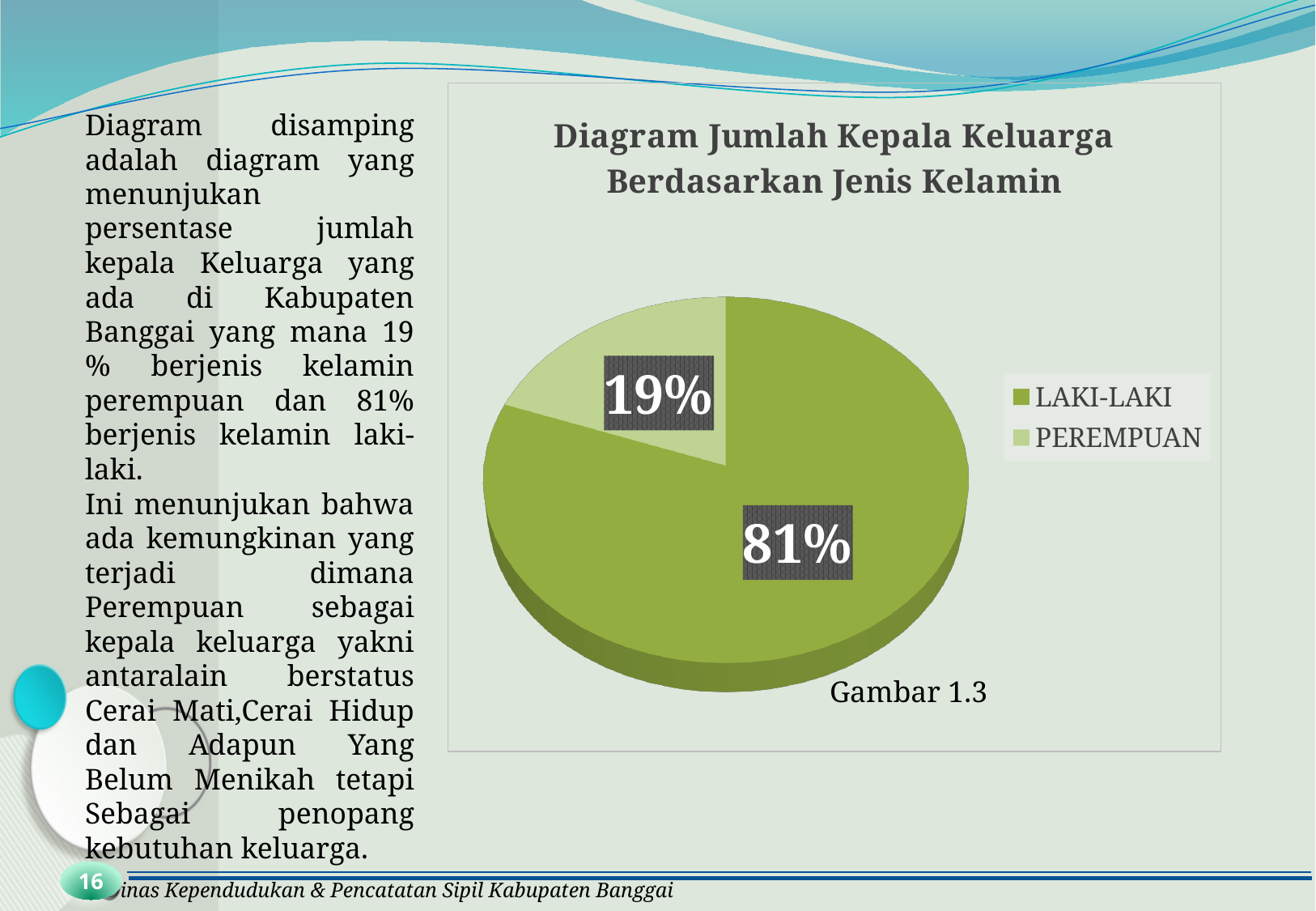
What figure caption appears below the pie chart? Gambar 1.3 Which category has the largest slice of the pie? LAKI-LAKI What kind of chart is shown on the slide? Pie chart How many categories are shown in the pie chart? 2 What is the difference in percentage points between the LAKI-LAKI and PEREMPUAN slices? 62 Which slice is larger, LAKI-LAKI or PEREMPUAN? LAKI-LAKI How many entries does the legend list? 2 What share of the pie does PEREMPUAN represent? 19% What share of the pie does LAKI-LAKI represent? 81% Which category has the smallest slice of the pie? PEREMPUAN What is the title of the chart? Diagram Jumlah Kepala Keluarga Berdasarkan Jenis Kelamin